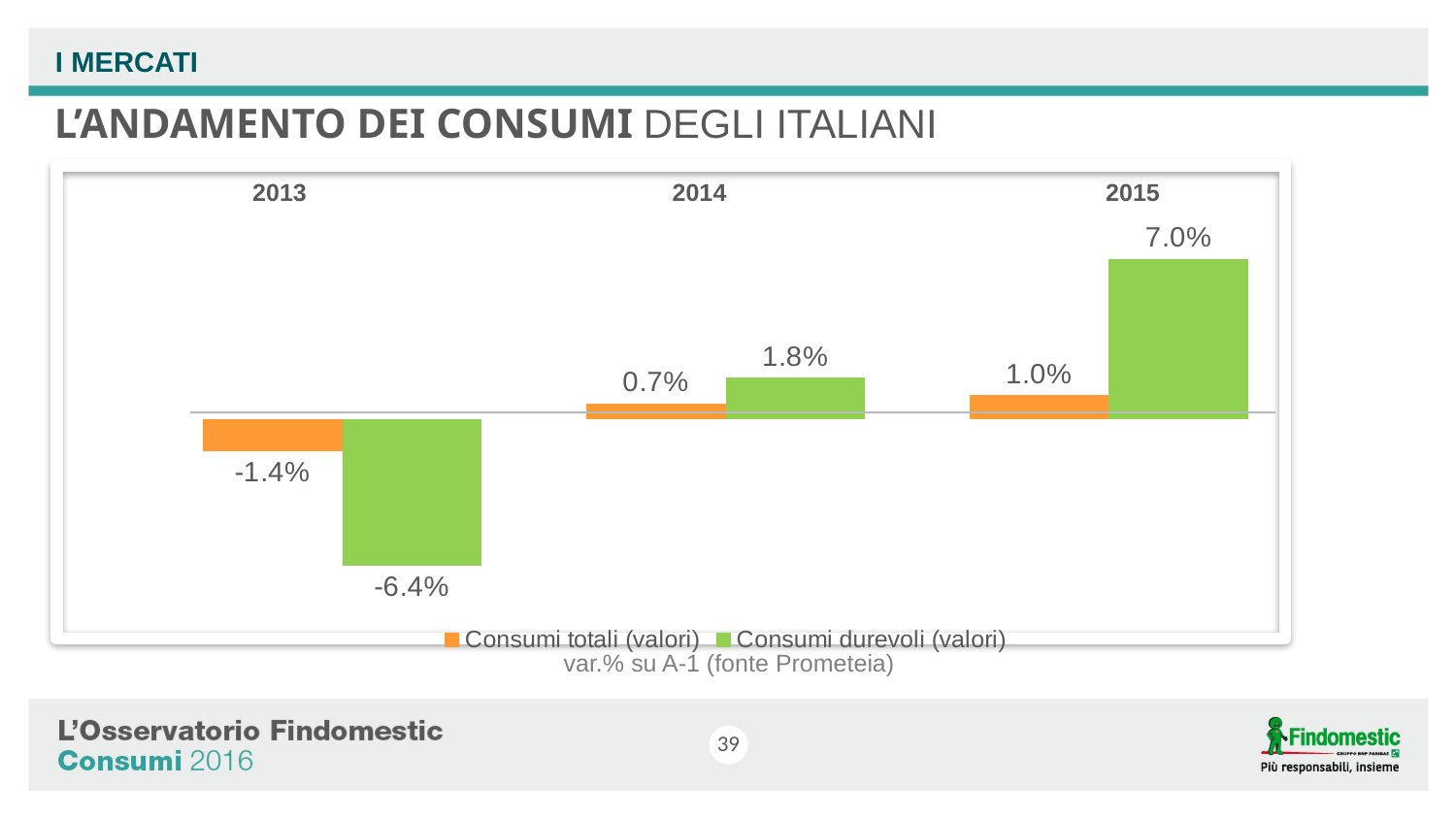
What is the difference between Consumi durevoli (valori) and Consumi totali (valori) in 2015? 6.0% Which is larger in 2014, Consumi totali (valori) or Consumi durevoli (valori)? Consumi durevoli (valori) In which year is Consumi durevoli (valori) highest? 2015 What is the value for Consumi durevoli (valori) in 2015? 7.0% What is the value for Consumi totali (valori) in 2013? -1.4% What is the value for Consumi durevoli (valori) in 2014? 1.8% How many years are shown on the x axis? 3 Do the values for Consumi durevoli (valori) rise or fall from 2013 to 2015? Rise What is the value for Consumi totali (valori) in 2015? 1.0% In which year is Consumi durevoli (valori) lowest? 2013 What kind of chart is shown on the slide? Bar chart How many series does the legend list? 2